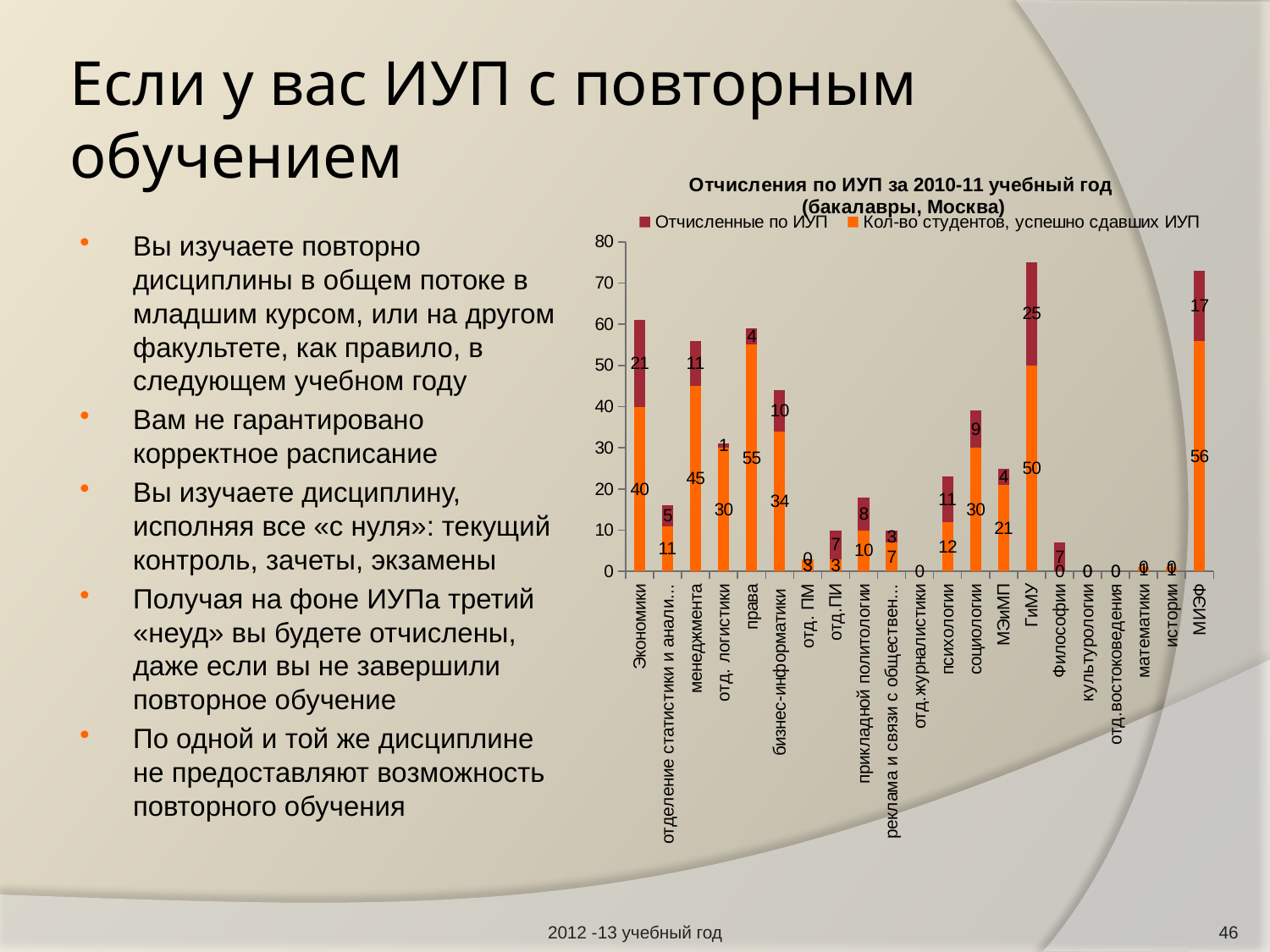
What is the total height of the stacked bar for ГиМУ? 75 Which category has the highest number of expelled students (Отчисленные по ИУП)? ГиМУ How many students were expelled (Отчисленные по ИУП) for МИЭФ? 17 How many students were expelled (Отчисленные по ИУП) for Экономики? 21 Which has more students who successfully passed the ИУП: менеджмента or социологии? менеджмента What is the title of the chart? Отчисления по ИУП за 2010-11 учебный год (бакалавры, Москва) Is the total stacked value for бизнес-информатики greater or less than 50? less What kind of chart is shown on the slide? bar chart How many students successfully passed the ИУП (Кол-во студентов, успешно сдавших ИУП) for ГиМУ? 50 What is the total height of the stacked bar for Экономики? 61 How many series does the chart legend list? 2 What is the difference between the number of expelled students for ГиМУ and for МИЭФ? 8